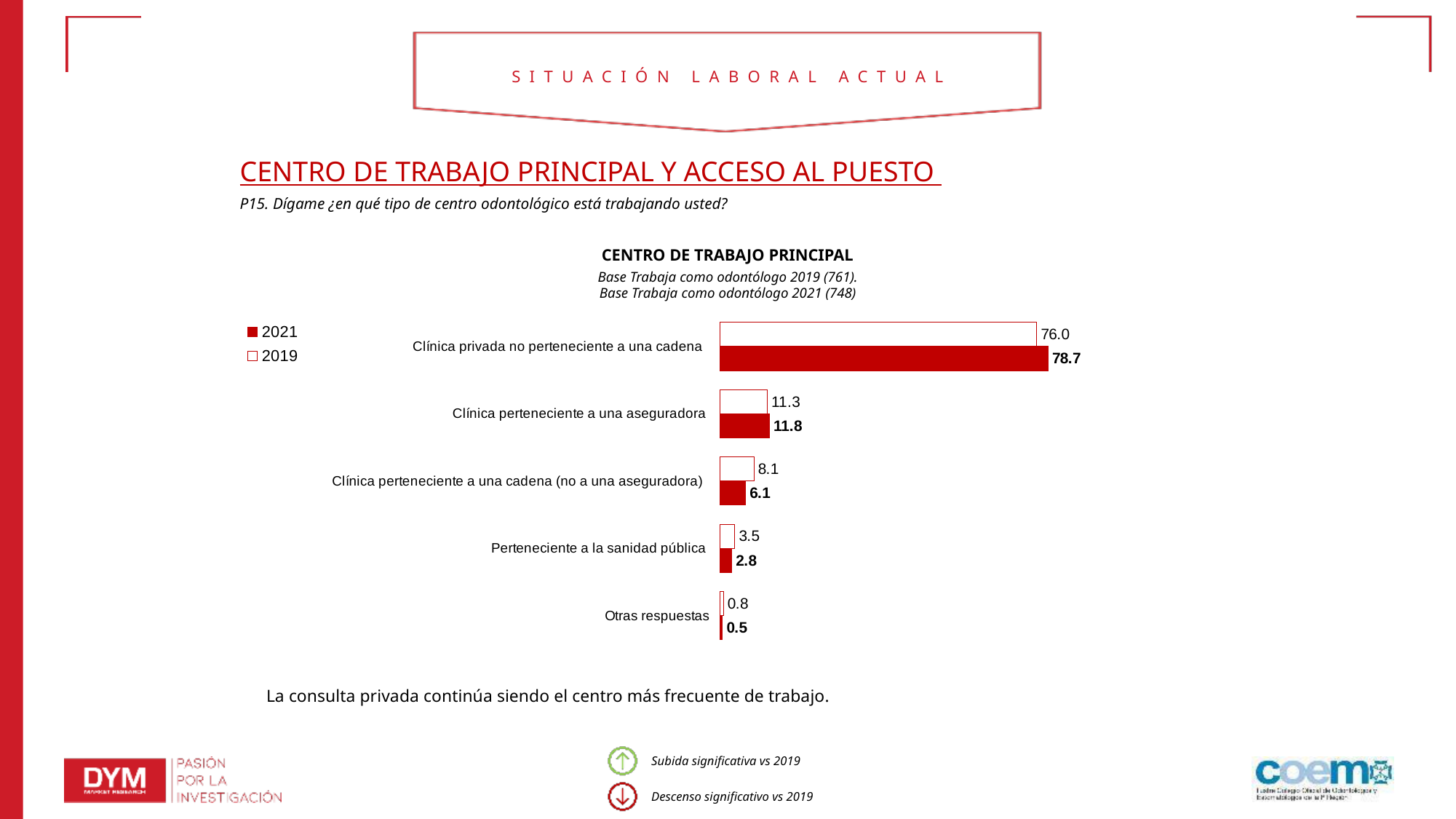
What is the 2021 value for 'Clínica privada no perteneciente a una cadena'? 78.7 What is the title of the chart? CENTRO DE TRABAJO PRINCIPAL What is the 2021 value for 'Perteneciente a la sanidad pública'? 2.8 Which category has the lowest 2019 value? Otras respuestas Which is larger for 'Clínica perteneciente a una cadena (no a una aseguradora)': the 2019 value or the 2021 value? 2019 What type of chart is shown on the slide? Bar chart How many categories are shown in the chart? 5 What is the 2019 value for 'Clínica perteneciente a una aseguradora'? 11.3 What is the difference between the 2021 and 2019 values for 'Clínica privada no perteneciente a una cadena'? 2.7 What is the 2019 value for 'Otras respuestas'? 0.8 Which category has the highest 2021 value? Clínica privada no perteneciente a una cadena How many series does the legend list? 2